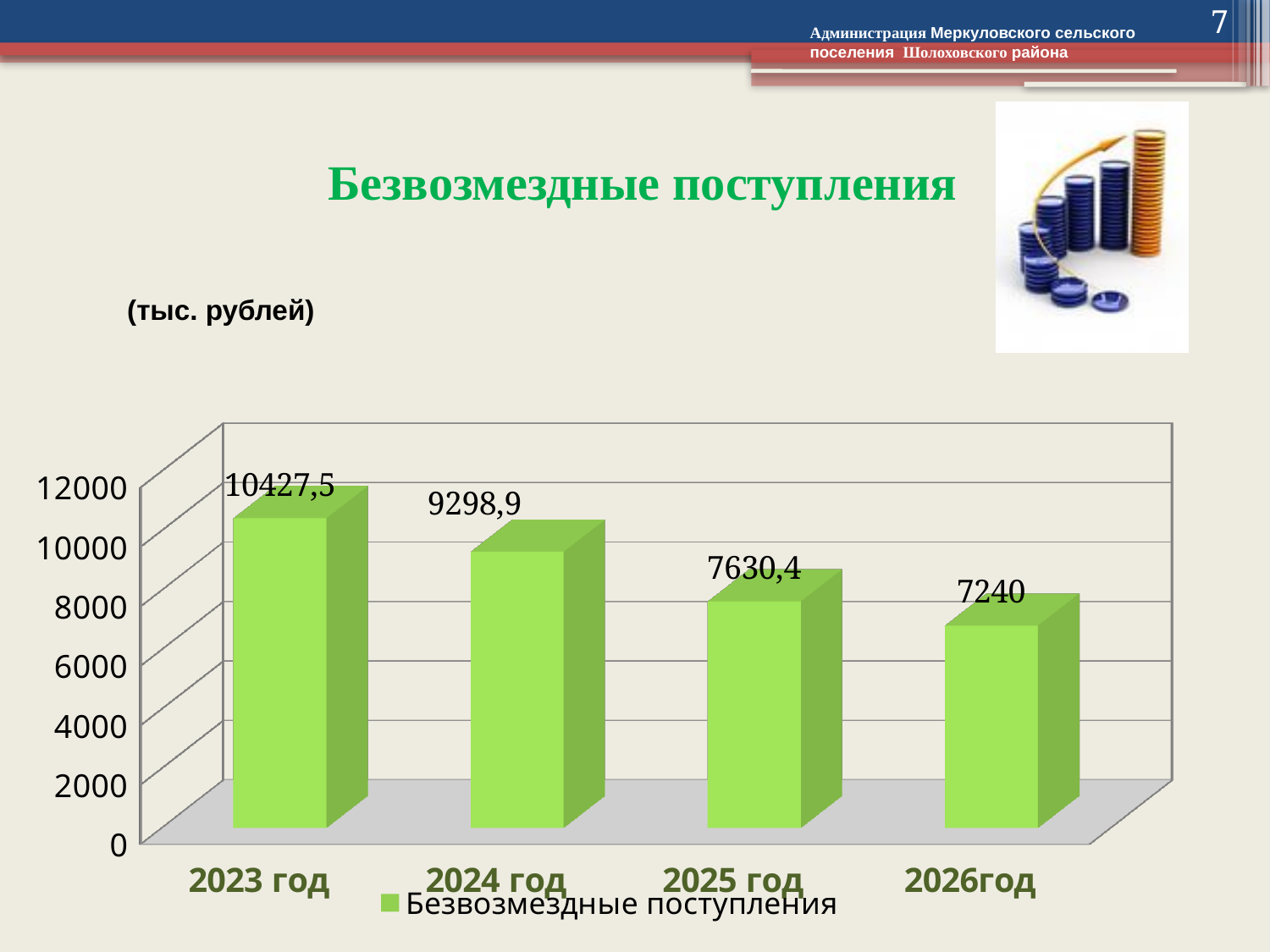
Which year has the highest value? 2023 год What is the difference between the values for 2023 год and 2024 год? 1128,6 Do the values rise or fall from 2023 год to 2026год? fall What kind of chart is shown on the slide? bar chart How many years are shown on the chart? 4 Which year has the lowest value? 2026год What is the value for 2026год? 7240 Which is larger, the value for 2024 год or the value for 2025 год? 2024 год How many series does the legend list? 1 What is the value for 2025 год? 7630,4 What is the value for 2023 год? 10427,5 What is the difference between the values for 2025 год and 2026год? 390,4